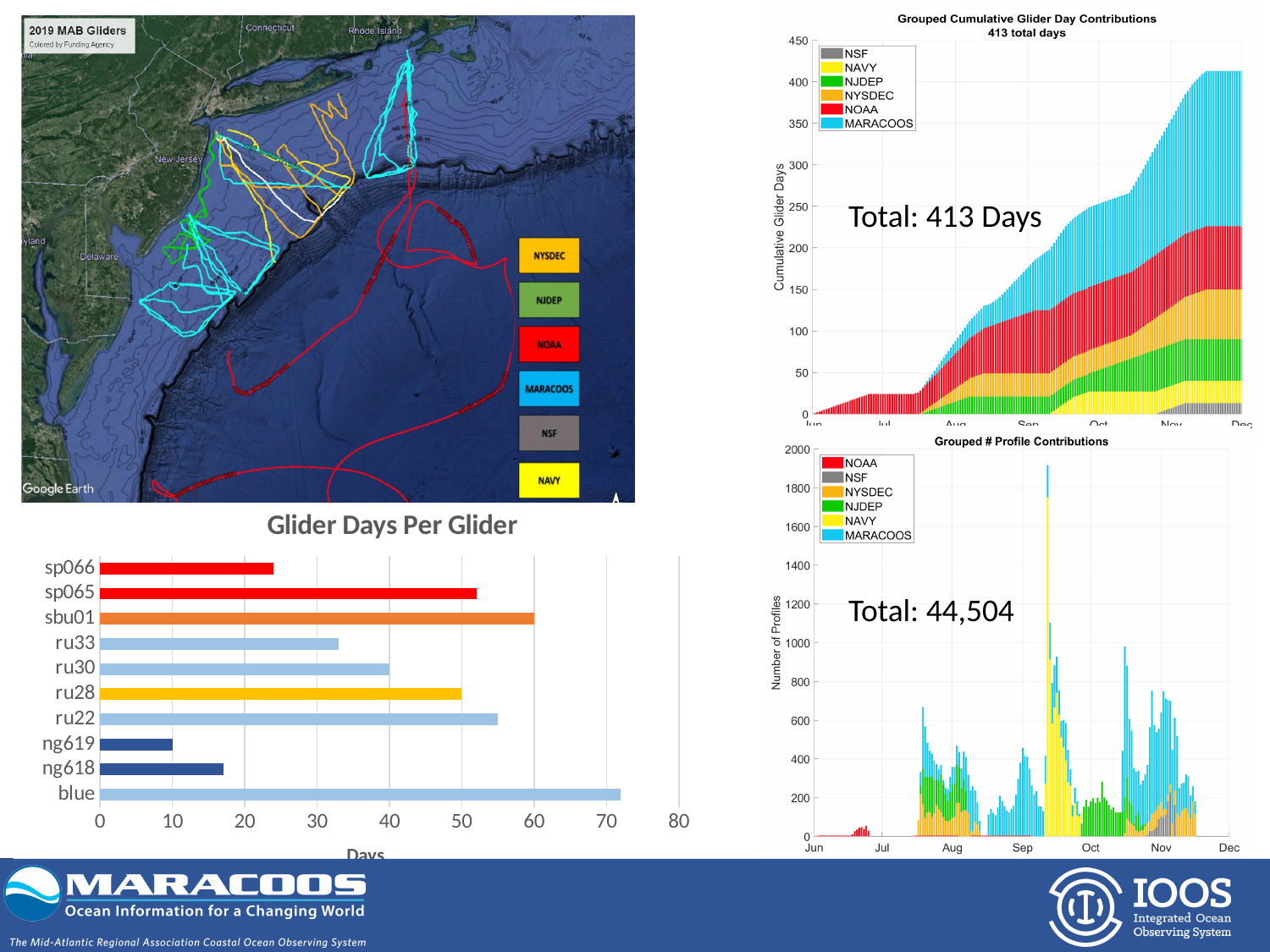
What kind of chart is 'Glider Days Per Glider'? bar chart What is the total number of profiles shown in the 'Grouped # Profile Contributions' chart? 44,504 In the 'Glider Days Per Glider' chart, which has more glider days, sbu01 or sp066? sbu01 What is the total number of days shown in the 'Grouped Cumulative Glider Day Contributions' chart? 413 Days In the 'Glider Days Per Glider' chart, is the value for ng619 greater or less than 20? less In the 'Glider Days Per Glider' chart, is the value for sbu01 greater or less than 50? greater In the 'Glider Days Per Glider' chart, which glider has the most glider days? blue In the 'Glider Days Per Glider' chart, which glider has the fewest glider days? ng619 In the 'Glider Days Per Glider' chart, which has more glider days, ru22 or ru33? ru22 In the 'Glider Days Per Glider' chart, is the value for blue greater or less than 70? greater How many series does the legend of the 'Grouped Cumulative Glider Day Contributions' chart list? 6 How many gliders are listed in the 'Glider Days Per Glider' chart? 10